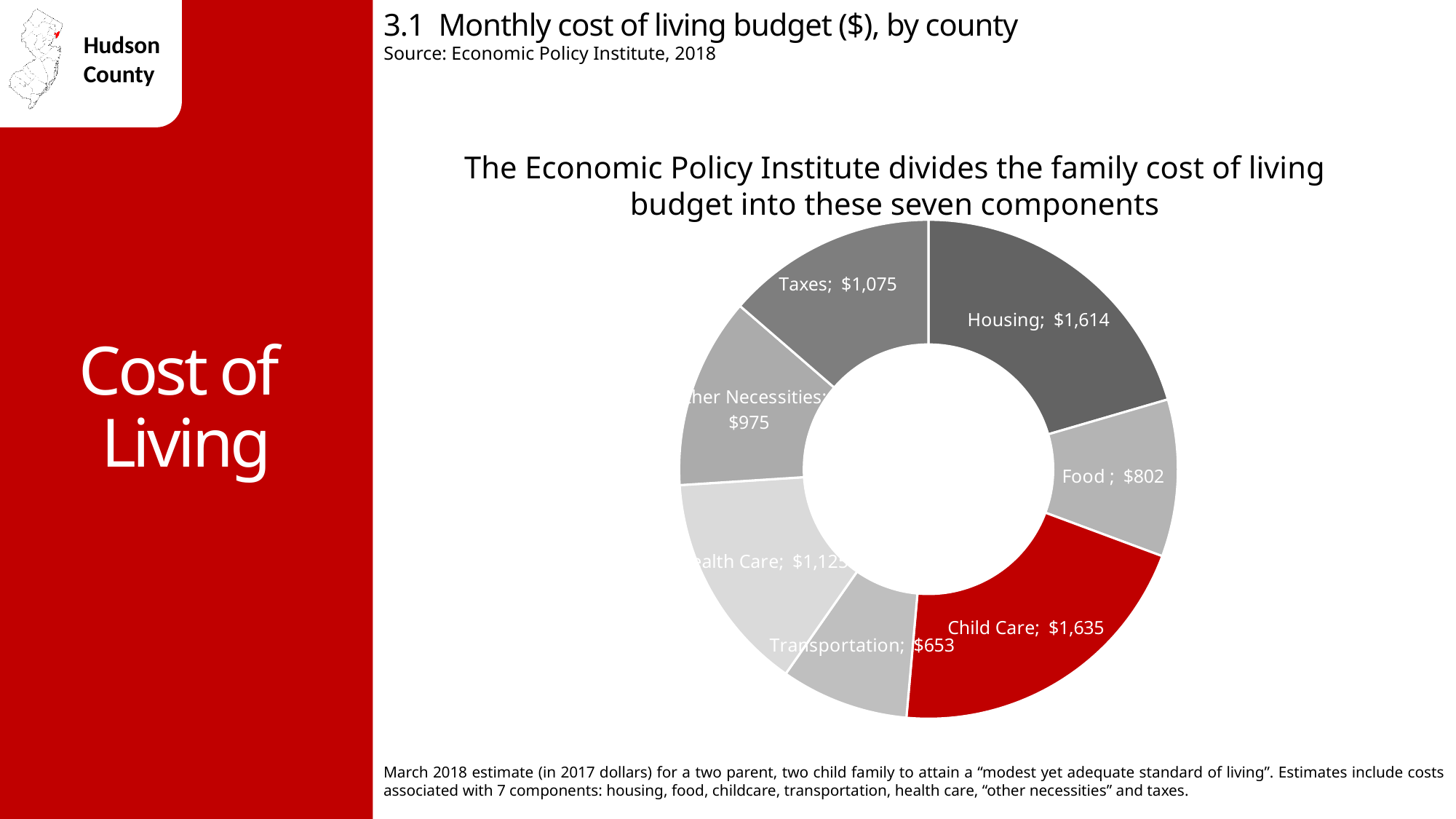
What kind of chart is shown on the slide? Doughnut (pie) chart Which component has the lowest monthly cost? Transportation Which is larger, the Child Care cost or the Housing cost? Child Care What is the monthly Taxes value shown on the chart? $1,075 What is the difference between the Taxes value and the Other Necessities value? $100 How many components does the chart divide the cost of living budget into? 7 How much larger is the Housing cost than the Food cost? $812 What is the monthly Transportation cost shown on the chart? $653 Which component has the highest monthly cost? Child Care What is the monthly Child Care cost shown on the chart? $1,635 What is the monthly Food cost shown on the chart? $802 What is the monthly Housing cost shown on the chart? $1,614